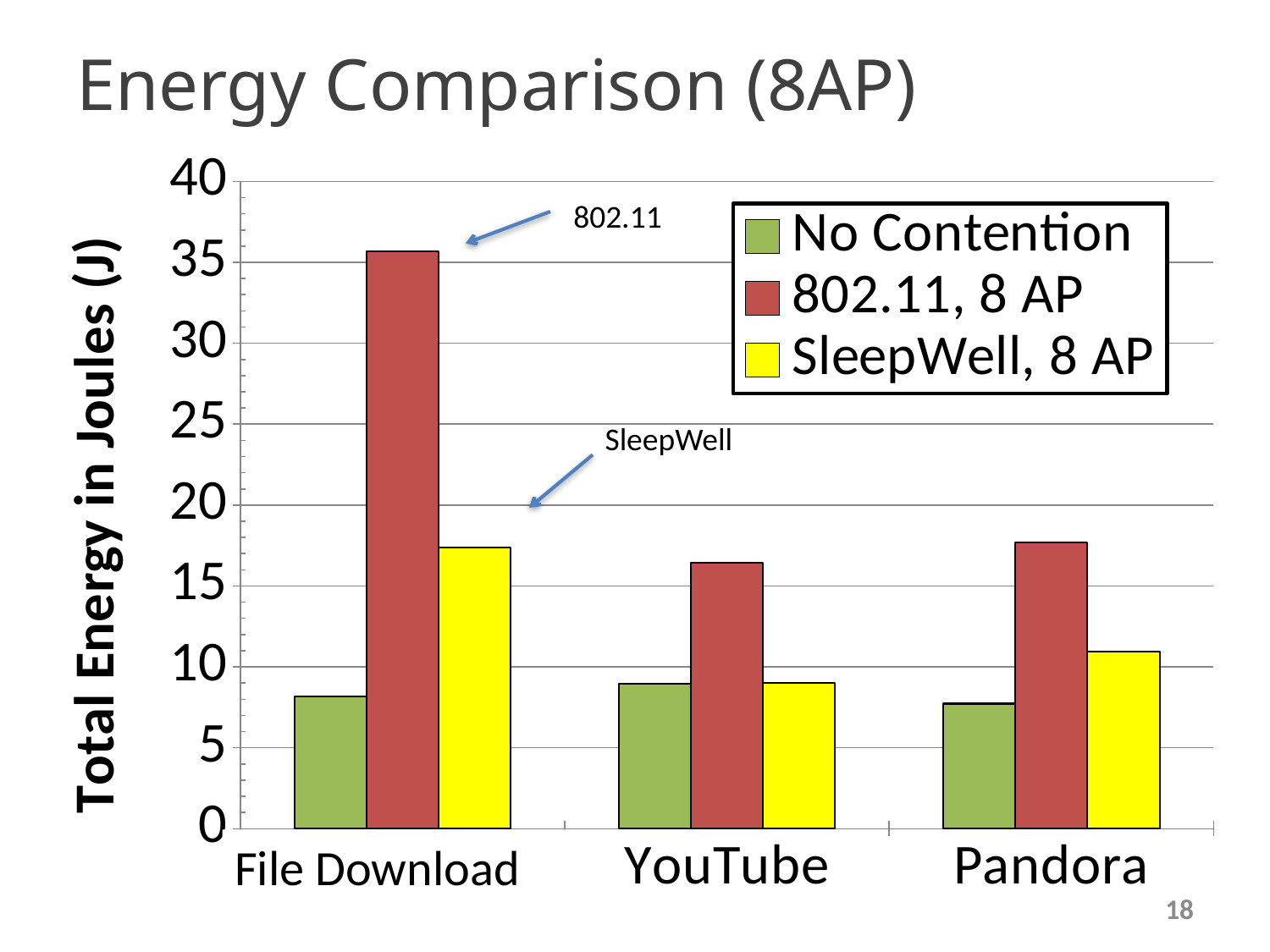
Is the value for No Contention in the Pandora category greater or less than 10? less Is the value for SleepWell, 8 AP in the File Download category greater or less than 15? greater Which series has the highest value in the File Download category? 802.11, 8 AP What kind of chart is shown on the slide? bar chart Which is larger for the SleepWell, 8 AP series: YouTube or Pandora? Pandora Is the value for 802.11, 8 AP in the YouTube category greater or less than 15? greater Which category has the highest value for the 802.11, 8 AP series? File Download How many categories are shown on the x axis? 3 What is the title of the y axis? Total Energy in Joules (J) How many series does the legend list? 3